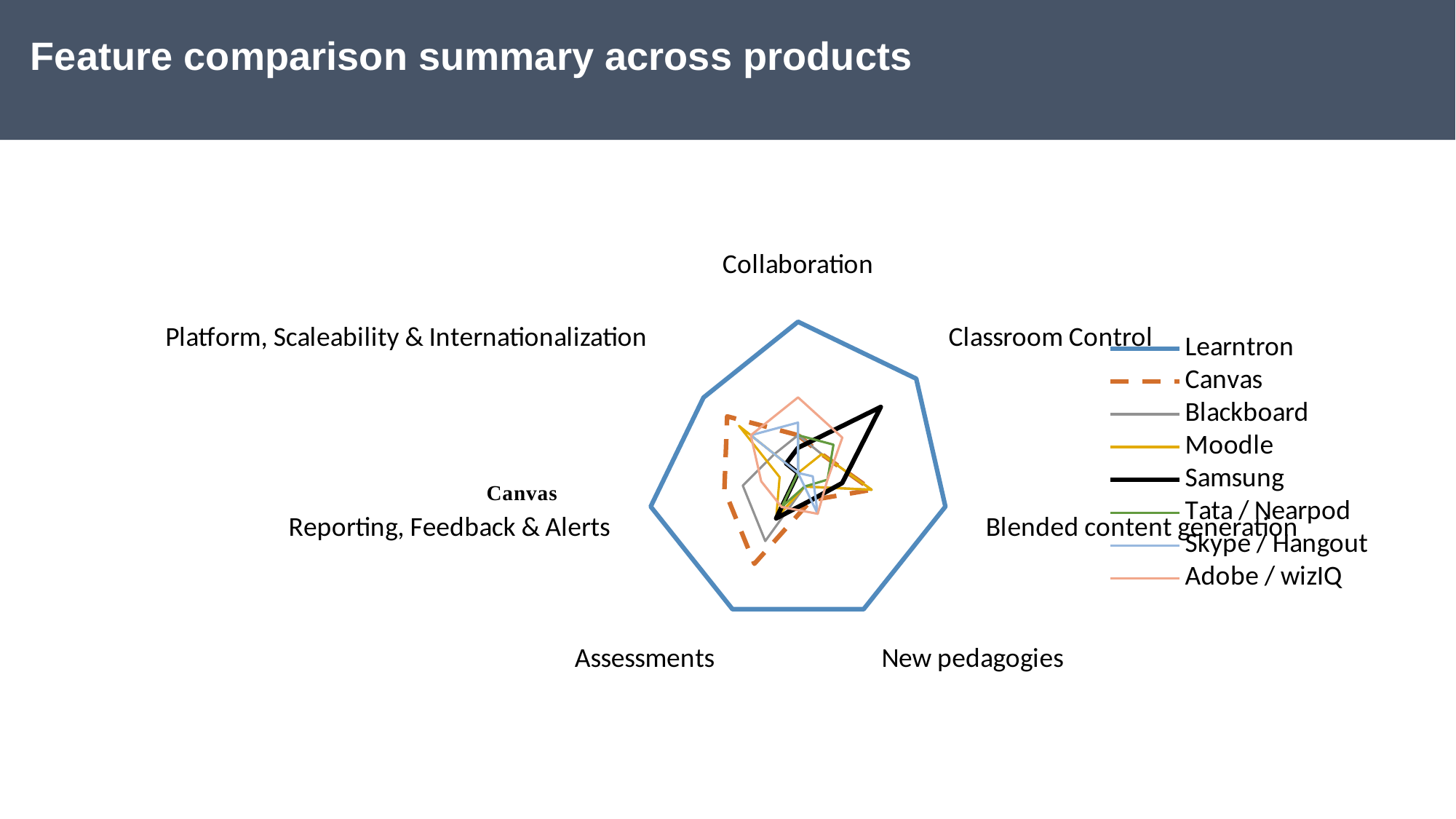
Which series has the highest value for Collaboration? Learntron What is the title of the slide containing the chart? Feature comparison summary across products Which series is drawn with a dashed orange line? Canvas Which series has the highest value for Assessments? Learntron How many series does the legend list? 8 What kind of chart is shown on the slide? Radar chart Which series has the larger value for Classroom Control, Samsung or Moodle? Samsung How many feature categories (axes) does the radar chart have? 7 Which series has the larger value for Classroom Control, Learntron or Samsung? Learntron Which series has the larger value for Reporting, Feedback & Alerts, Learntron or Adobe / wizIQ? Learntron